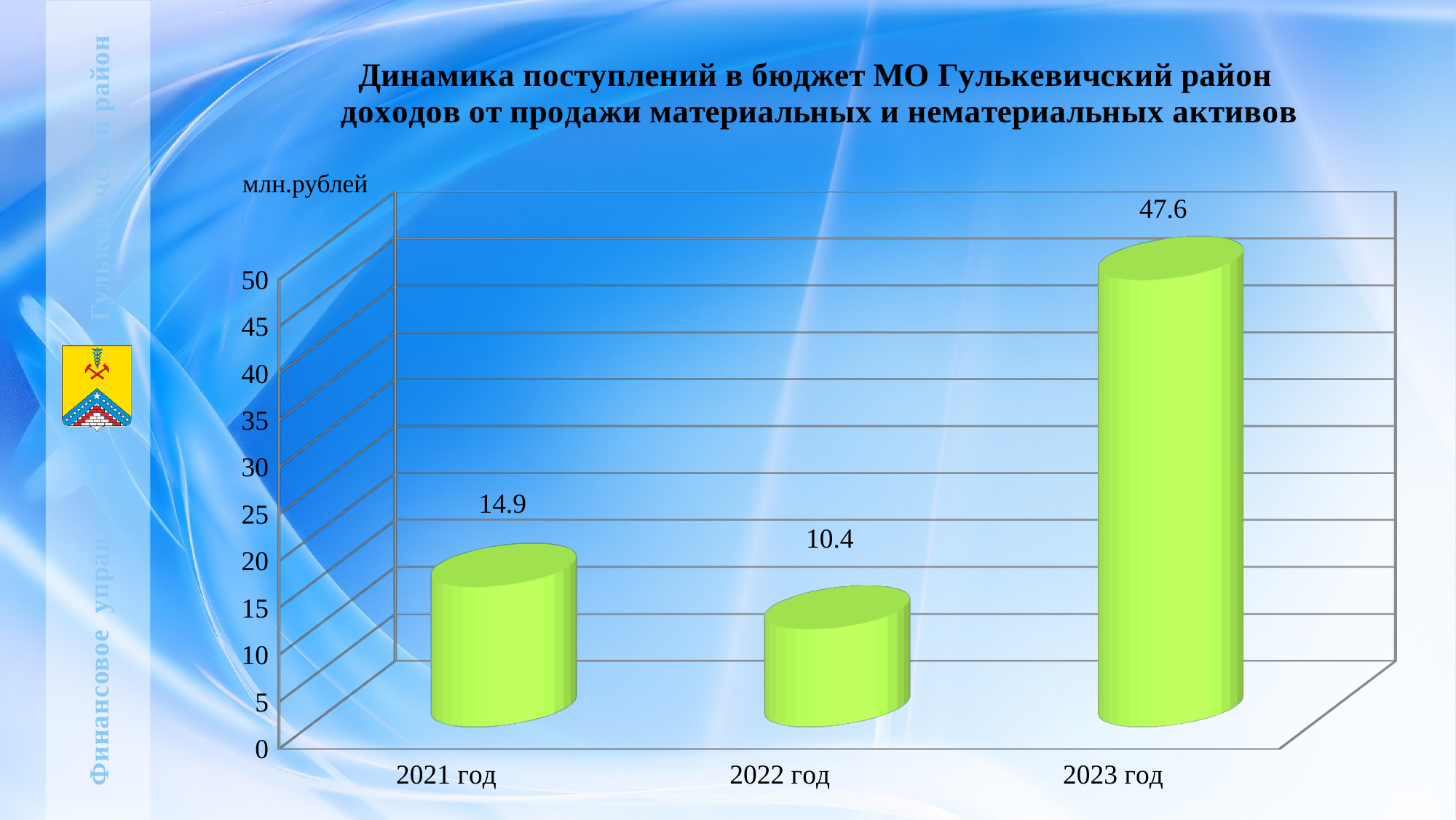
How many years are shown on the chart? 3 Which year has the highest value? 2023 год What is the difference between the values for 2021 год and 2022 год? 4.5 What kind of chart is shown on the slide? bar chart Which year has the lowest value? 2022 год What is the value for 2022 год? 10.4 What is the difference between the values for 2023 год and 2022 год? 37.2 What unit is shown on the chart's axis label? млн.рублей What is the value for 2023 год? 47.6 Is the value for 2023 год greater or less than 40? greater What is the value for 2021 год? 14.9 Which is larger, the value for 2021 год or the value for 2022 год? 2021 год